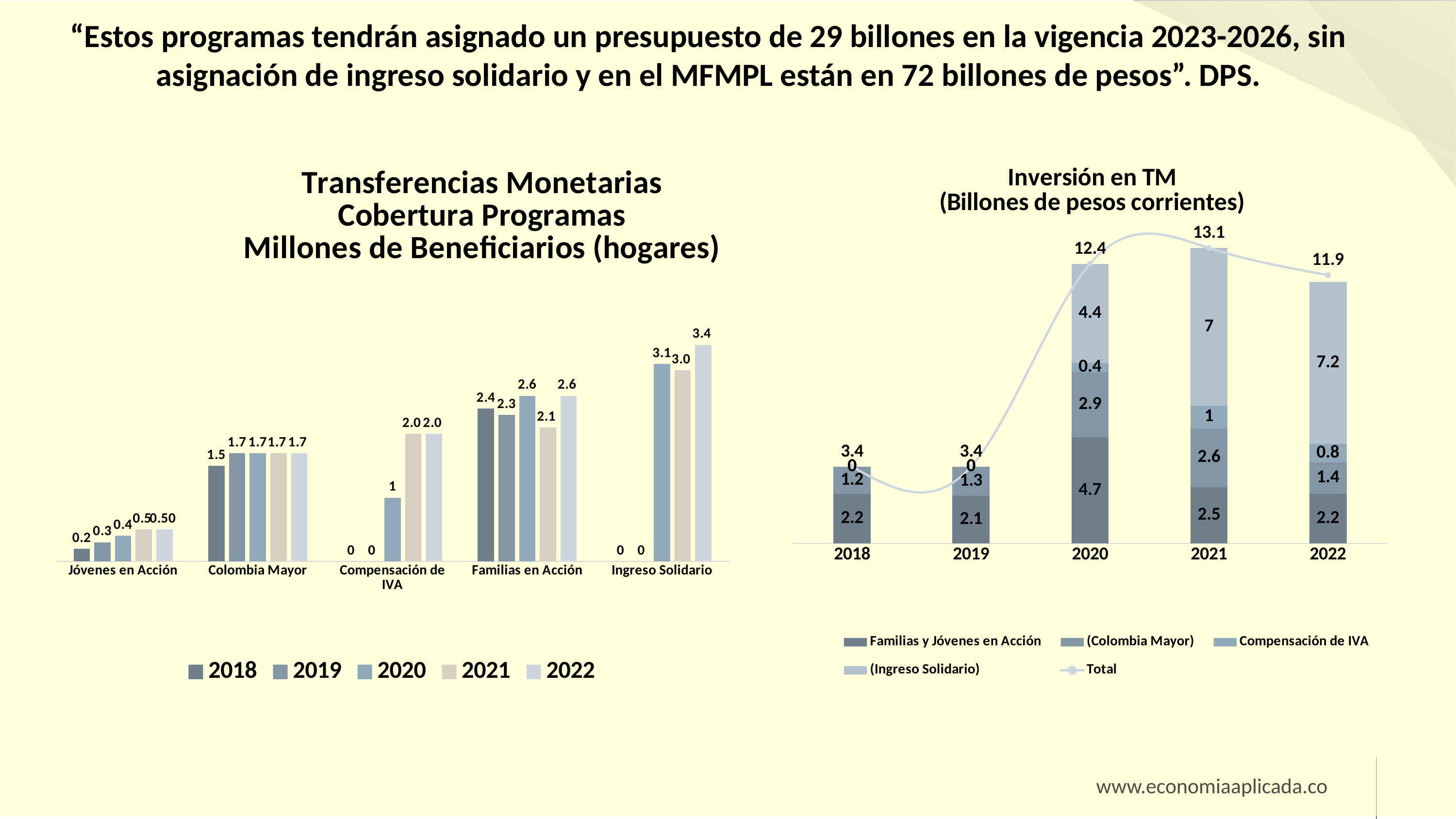
What kind of chart is the 'Inversión en TM' chart? Stacked bar chart with a total line In the 'Transferencias Monetarias Cobertura Programas' chart, how many program categories are shown on the x axis? 5 In the 'Transferencias Monetarias Cobertura Programas' chart, what is the difference between the 2022 and 2018 values for Jóvenes en Acción? 0.3 In the 'Transferencias Monetarias Cobertura Programas' chart, which category has the highest value in 2022? Ingreso Solidario In the 'Inversión en TM' chart, what is the Ingreso Solidario value for 2022? 7.2 In the 'Transferencias Monetarias Cobertura Programas' chart, what is the value for Colombia Mayor in 2018? 1.5 In the 'Inversión en TM' chart, is the total for 2020 larger or smaller than the total for 2022? larger In the 'Inversión en TM' chart, what is the total for 2021? 13.1 In the 'Inversión en TM' chart, what is the difference between the totals for 2021 and 2020? 0.7 In the 'Inversión en TM' chart, which year has the lowest total? 2018 and 2019 (3.4) In the 'Transferencias Monetarias Cobertura Programas' chart, what is the value for Ingreso Solidario in 2022? 3.4 In the 'Transferencias Monetarias Cobertura Programas' chart, how many series does the legend list? 5